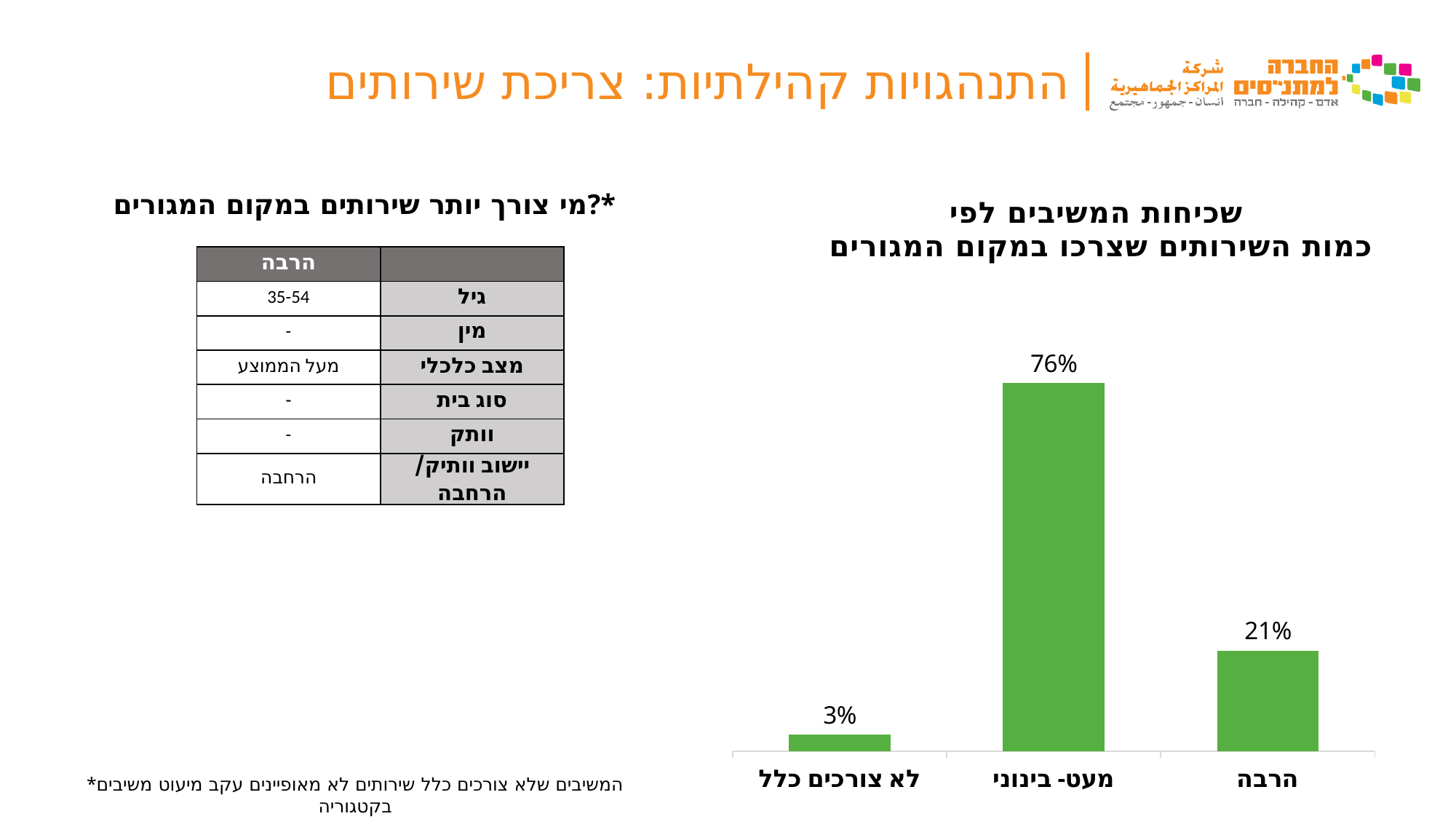
What colour are the bars in the chart? green What type of chart is shown on the slide? bar chart How many categories are shown in the chart? 3 What is the difference between the values for "מעט- בינוני" and "הרבה"? 55% Which category has the lowest value in the chart? לא צורכים כלל What is the value shown for the "הרבה" category? 21% What percentage of respondents are in the "מעט- בינוני" category? 76% Which category has the highest value in the chart? מעט- בינוני Which is larger, the value for "הרבה" or the value for "לא צורכים כלל"? הרבה What is the value shown for the "לא צורכים כלל" category? 3% What is the title of the chart? שכיחות המשיבים לפי כמות השירותים שצרכו במקום המגורים What is the difference between the values for "הרבה" and "לא צורכים כלל"? 18%